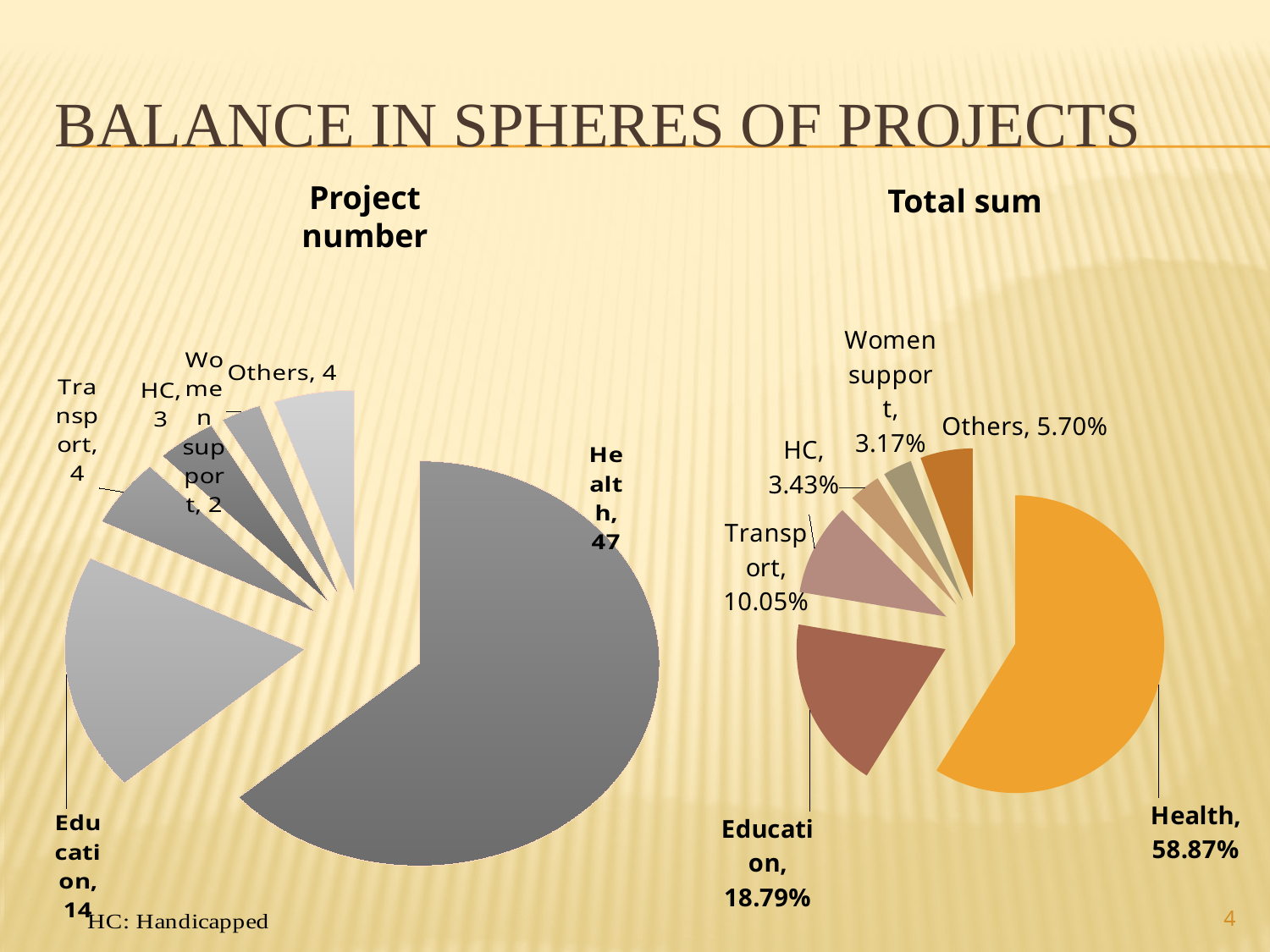
In the "Project number" chart, how many projects are in Health? 47 In the "Project number" chart, what is the value for Education? 14 In the "Total sum" chart, what share does Transport have? 10.05% How many categories does the "Total sum" pie chart show? 6 In the "Project number" chart, what is the difference between the Health and Education values? 33 What type of chart is the "Project number" chart? Pie chart In the "Total sum" chart, which category has the smallest share? Women support In the "Project number" chart, which category has the smallest number of projects? Women support In the "Total sum" chart, what is the percentage for Women support? 3.17% According to the footnote on the slide, what does HC stand for? Handicapped In the "Total sum" chart, which is larger: the share for Others or the share for HC? Others In the "Project number" chart, which category has the largest number of projects? Health